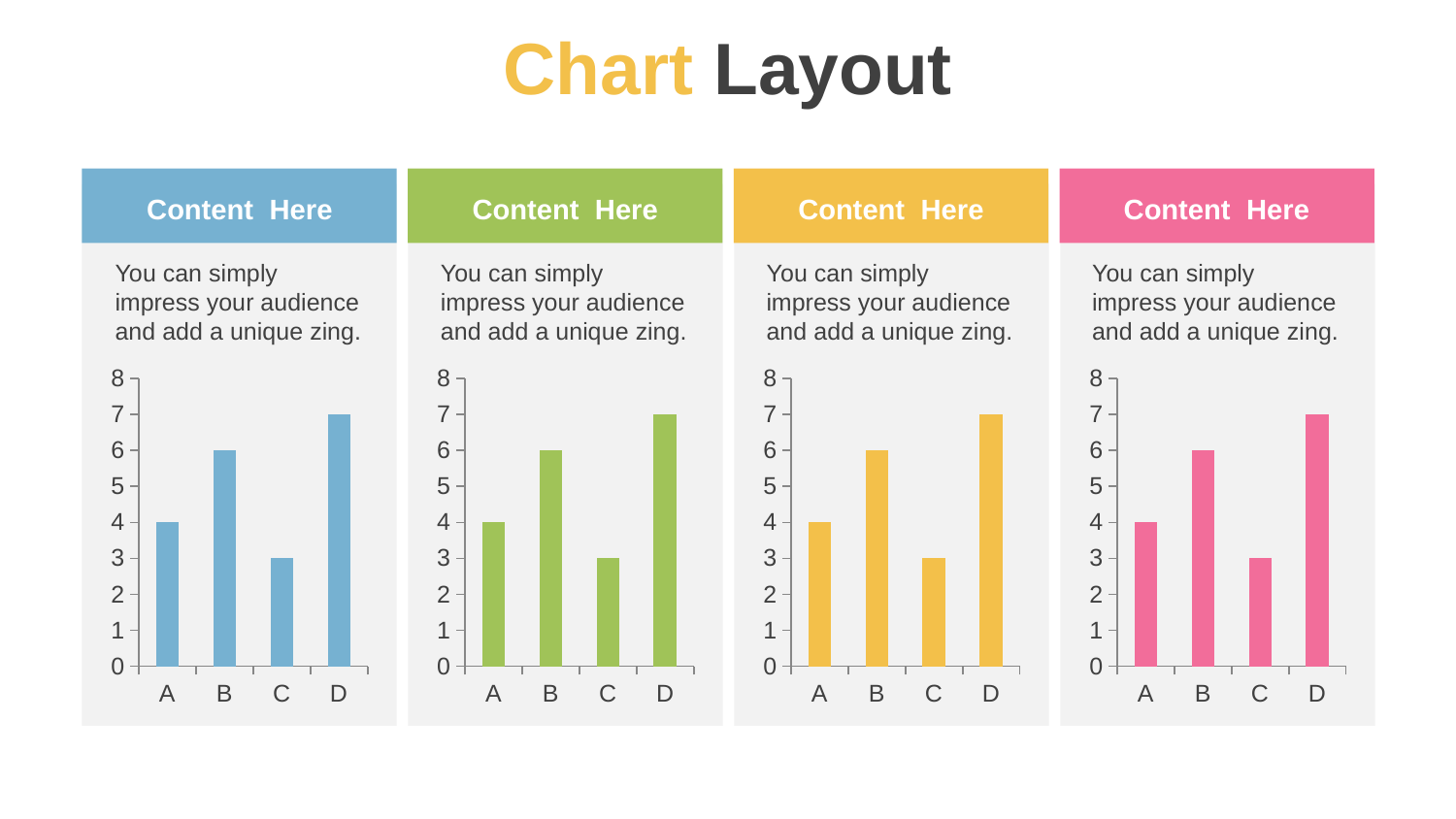
In the second chart from the left (green), what is the value for category A? 4 In the leftmost (blue) chart, what is the value for category D? 7 In the rightmost (pink) chart, which category has the highest value? D In the rightmost (pink) chart, what is the value for category B? 6 How many categories are shown on the x axis of the rightmost (pink) chart? 4 In the third chart from the left (yellow), is the value for B greater or less than 5? greater In the leftmost (blue) chart, what is the difference between the values for D and C? 4 What kind of chart is the leftmost (blue) chart? bar chart How many charts are shown on the slide? 4 In the second chart from the left (green), which is larger, the value for B or the value for A? B What is the maximum value shown on the y axis of the third chart from the left (yellow)? 8 In the third chart from the left (yellow), which category has the lowest value? C